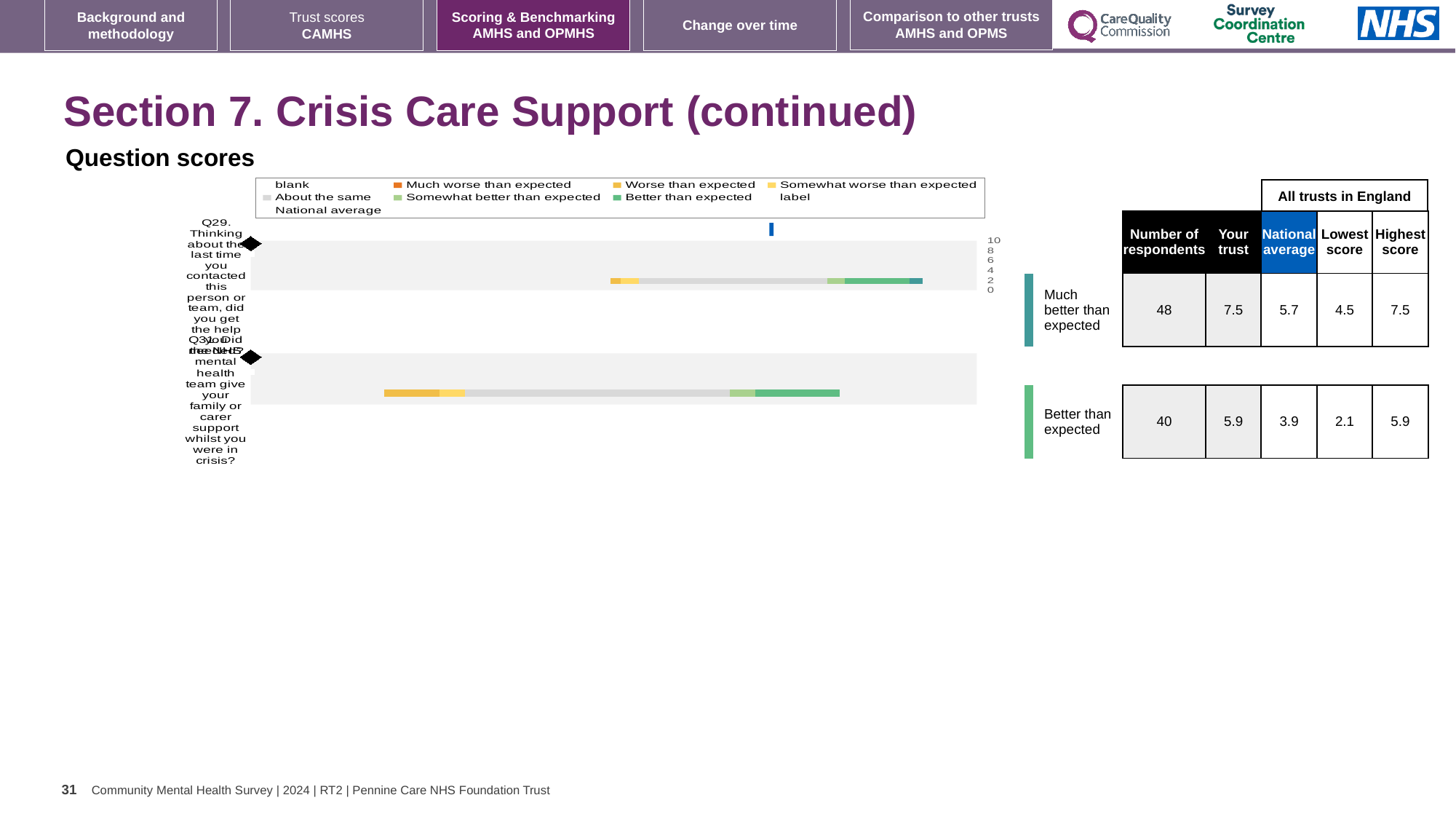
Which legend entry is shown in grey in the chart legend? About the same In the table beside the chart, what is the "Your trust" score for Q29? 7.5 Which legend entry is shown in dark green in the chart legend? Better than expected In the table beside the chart, which question has the higher "Your trust" score, Q29 or Q31? Q29 In the table beside the chart, what is the difference between the "Your trust" score and the national average for Q31? 2.0 What kind of chart is shown under the heading "Question scores"? bar chart In the table beside the chart, what is the lowest score for Q31? 2.1 In the table beside the chart, what is the national average for Q29? 5.7 In the table beside the chart, what is the number of respondents for Q31? 40 In the table beside the chart, what is the "Your trust" score for Q31? 5.9 In the table beside the chart, what is the difference between the highest score and the lowest score for Q29? 3.0 How many questions (bars) are plotted in the chart? 2